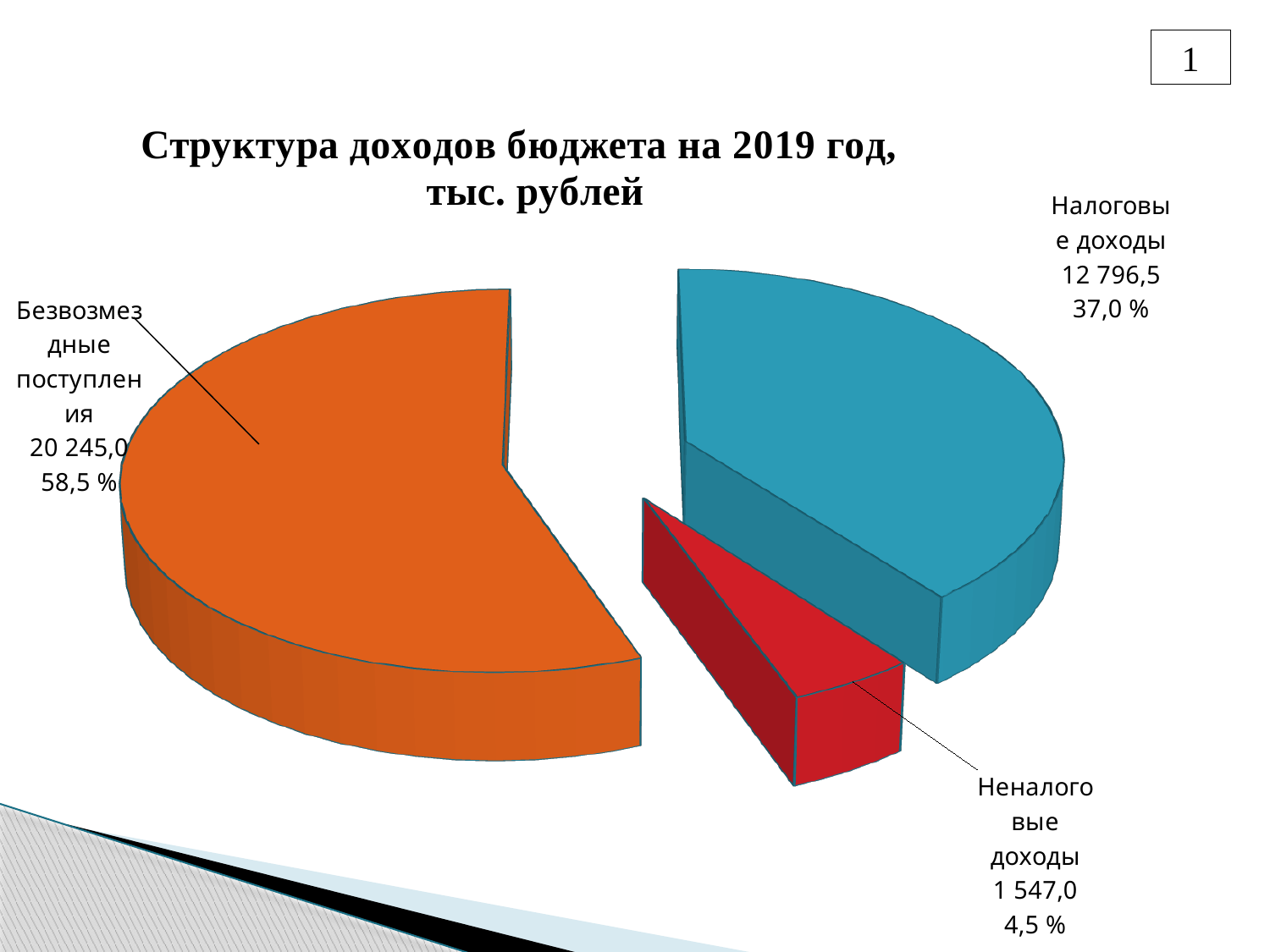
Which is larger, Налоговые доходы or Неналоговые доходы? Налоговые доходы What is the value for Налоговые доходы? 12 796,5 How many categories are shown in the chart? 3 What is the value for Безвозмездные поступления? 20 245,0 What share of the pie does Неналоговые доходы represent? 4,5 % Which category has the smallest slice? Неналоговые доходы What kind of chart is shown on the slide? Pie chart What is the difference between Безвозмездные поступления and Налоговые доходы? 7 448,5 What share of the pie does Налоговые доходы represent? 37,0 % Which category has the largest slice? Безвозмездные поступления What is the value for Неналоговые доходы? 1 547,0 What share of the pie does Безвозмездные поступления represent? 58,5 %